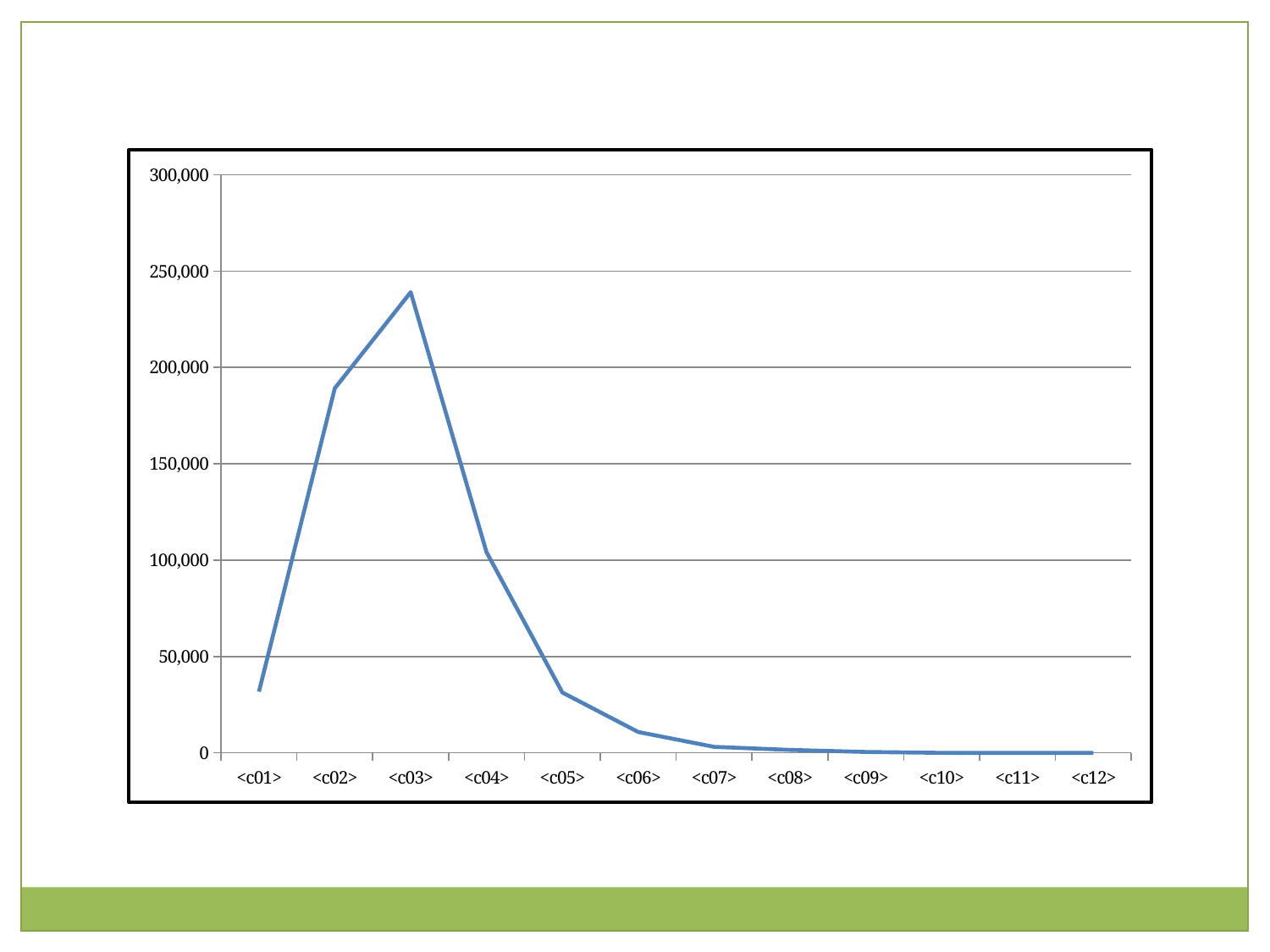
What kind of chart is shown on the slide? line chart Which is larger, the value for <c02> or the value for <c04>? <c02> Do the values rise or fall from <c03> to <c12>? fall Is the value for <c01> greater or less than 50,000? less Is the value for <c04> greater or less than 150,000? less Is the value for <c03> greater or less than 200,000? greater Which category has the highest value? <c03> Which is larger, the value for <c01> or the value for <c03>? <c03> How many categories are plotted along the x axis? 12 What is the highest value shown on the y axis? 300,000